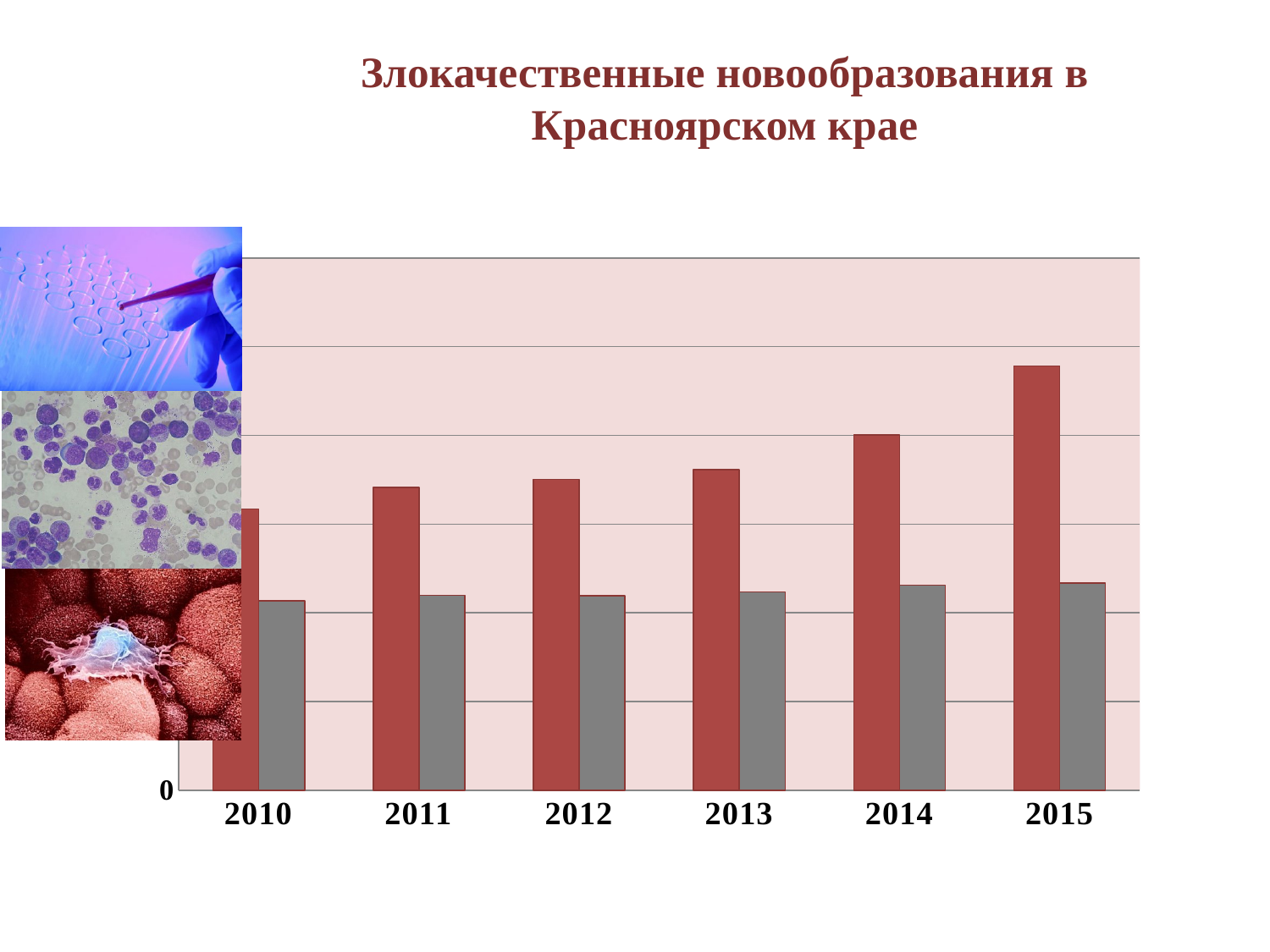
Is the red bar for 2014 taller or shorter than the red bar for 2013? taller Which year has the tallest red bar? 2015 What kind of chart is shown on the slide? bar chart In 2010, which bar is taller, the red one or the grey one? the red one Do the red bars rise or fall from 2010 to 2015? rise How many data series (bar colours) are plotted for each year? 2 Which year has the shortest red bar? 2010 How many years (categories) are shown on the x axis of the chart? 6 Which is taller, the red bar for 2010 or the red bar for 2015? the red bar for 2015 What is the first year shown on the x axis? 2010 What is the title of the slide's chart? Злокачественные новообразования в Красноярском крае